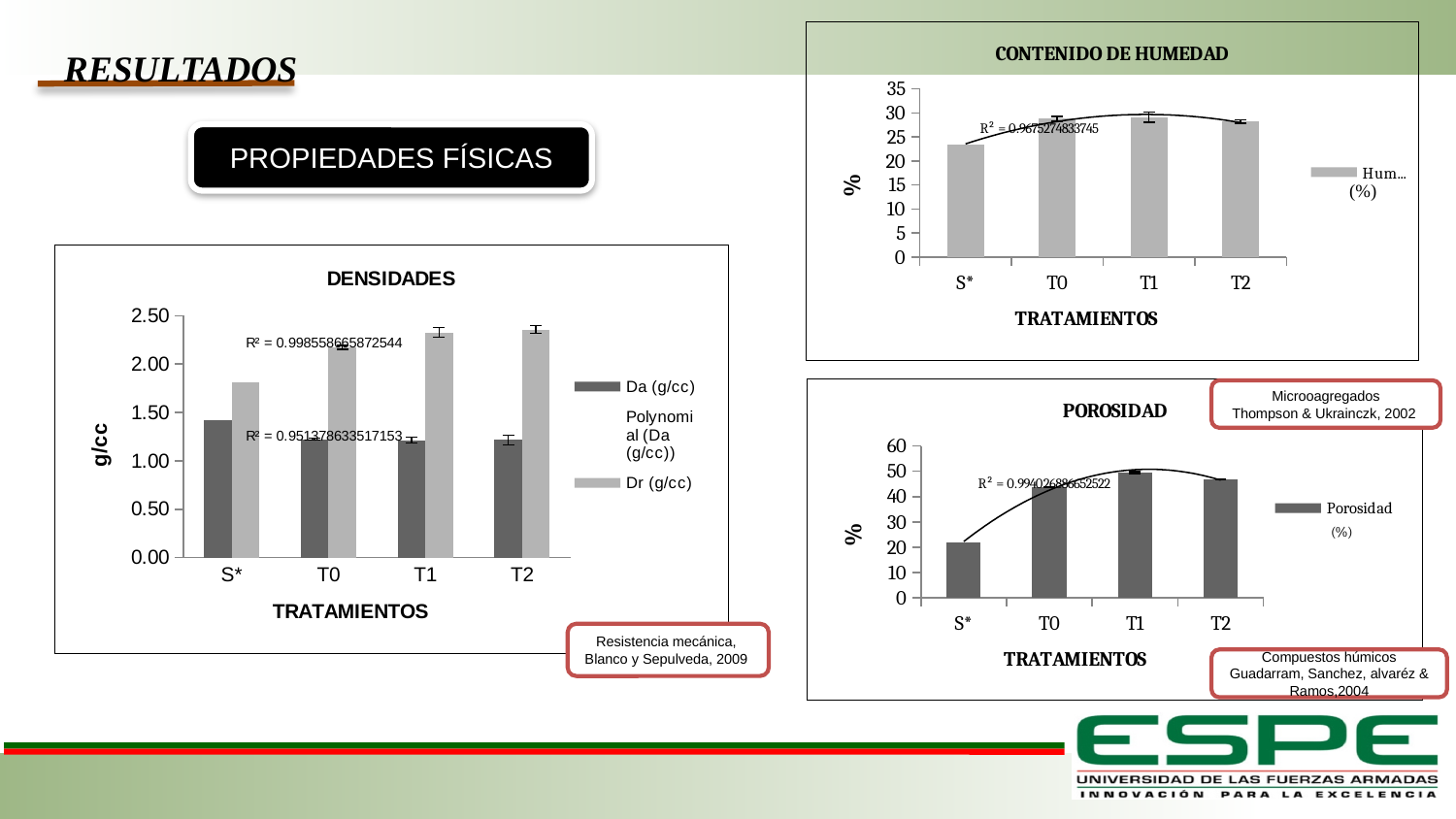
In the DENSIDADES chart, which treatment has the highest Da (g/cc) value? S* What is the y-axis label of the POROSIDAD chart? % In the CONTENIDO DE HUMEDAD chart, is the value for S* greater or less than 25? less In the DENSIDADES chart, is the Dr (g/cc) value for T1 greater or less than 2.00? greater In the POROSIDAD chart, which treatment has the lowest value? S* What kind of chart is the DENSIDADES chart? bar chart How many entries does the legend of the DENSIDADES chart list? 3 In the POROSIDAD chart, is the value for T1 greater or less than 40? greater In the DENSIDADES chart, which is larger for T0: Da (g/cc) or Dr (g/cc)? Dr (g/cc) How many treatment categories are shown on the x axis of the DENSIDADES chart? 4 In the CONTENIDO DE HUMEDAD chart, which treatment has the lowest value? S* In the DENSIDADES chart, which treatment has the lowest Dr (g/cc) value? S*